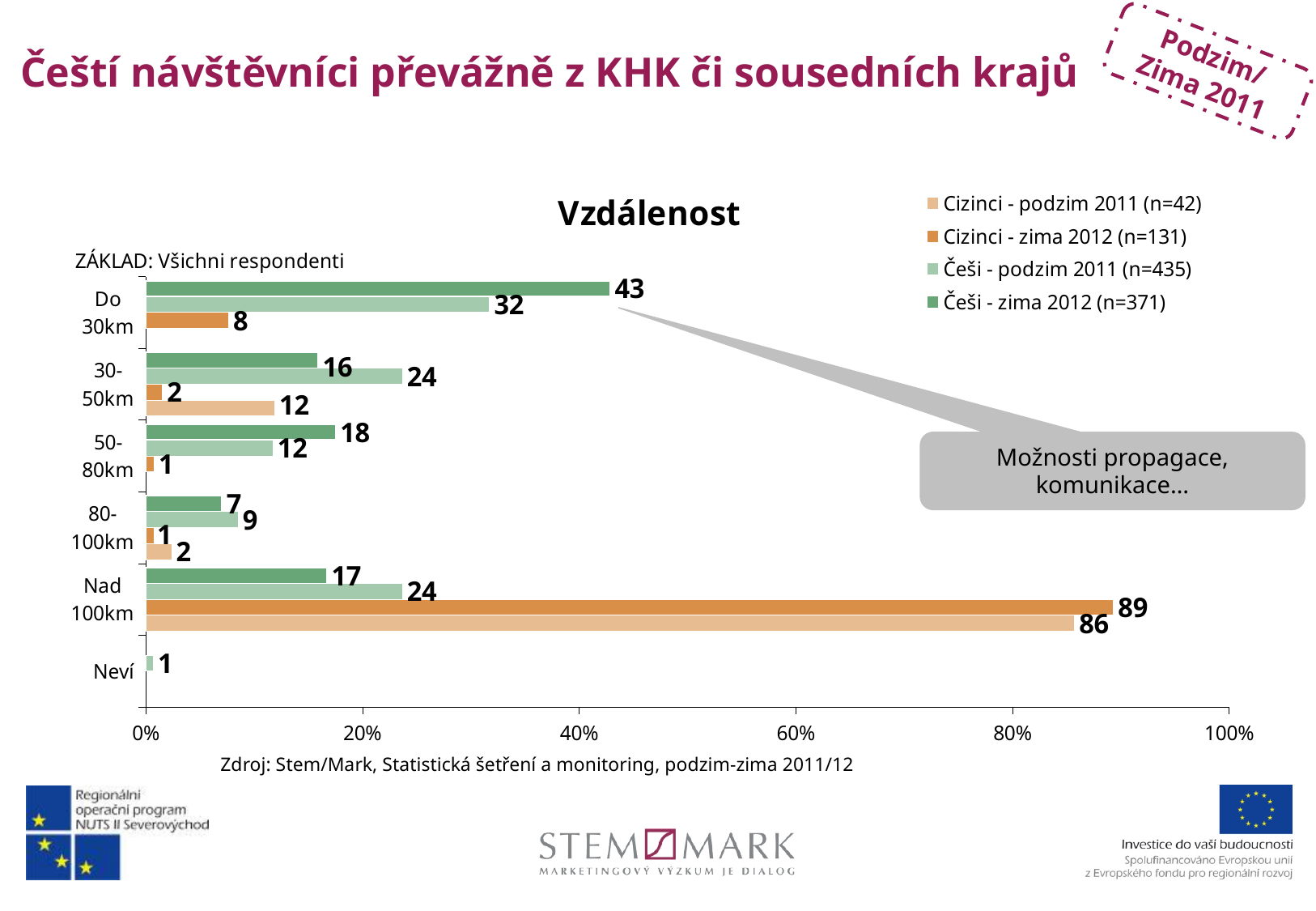
What is the difference between Češi - zima 2012 and Češi - podzim 2011 in the 'Do 30km' category? 11 Which category has the highest value for Cizinci - podzim 2011? Nad 100km What kind of chart is shown on the slide? bar chart What is the title of the chart? Vzdálenost What is the value for Cizinci - podzim 2011 in the '30-50km' category? 12 In the '30-50km' category, which is larger: Češi - podzim 2011 or Češi - zima 2012? Češi - podzim 2011 What is the value for Cizinci - zima 2012 in the 'Nad 100km' category? 89 What is the value for Češi - zima 2012 in the 'Do 30km' category? 43 How many distance categories are shown on the chart's vertical axis? 6 Which category has the highest value for Češi - zima 2012? Do 30km How many series does the chart legend list? 4 Is the value for Cizinci - podzim 2011 in the 'Nad 100km' category greater or less than 80%? greater